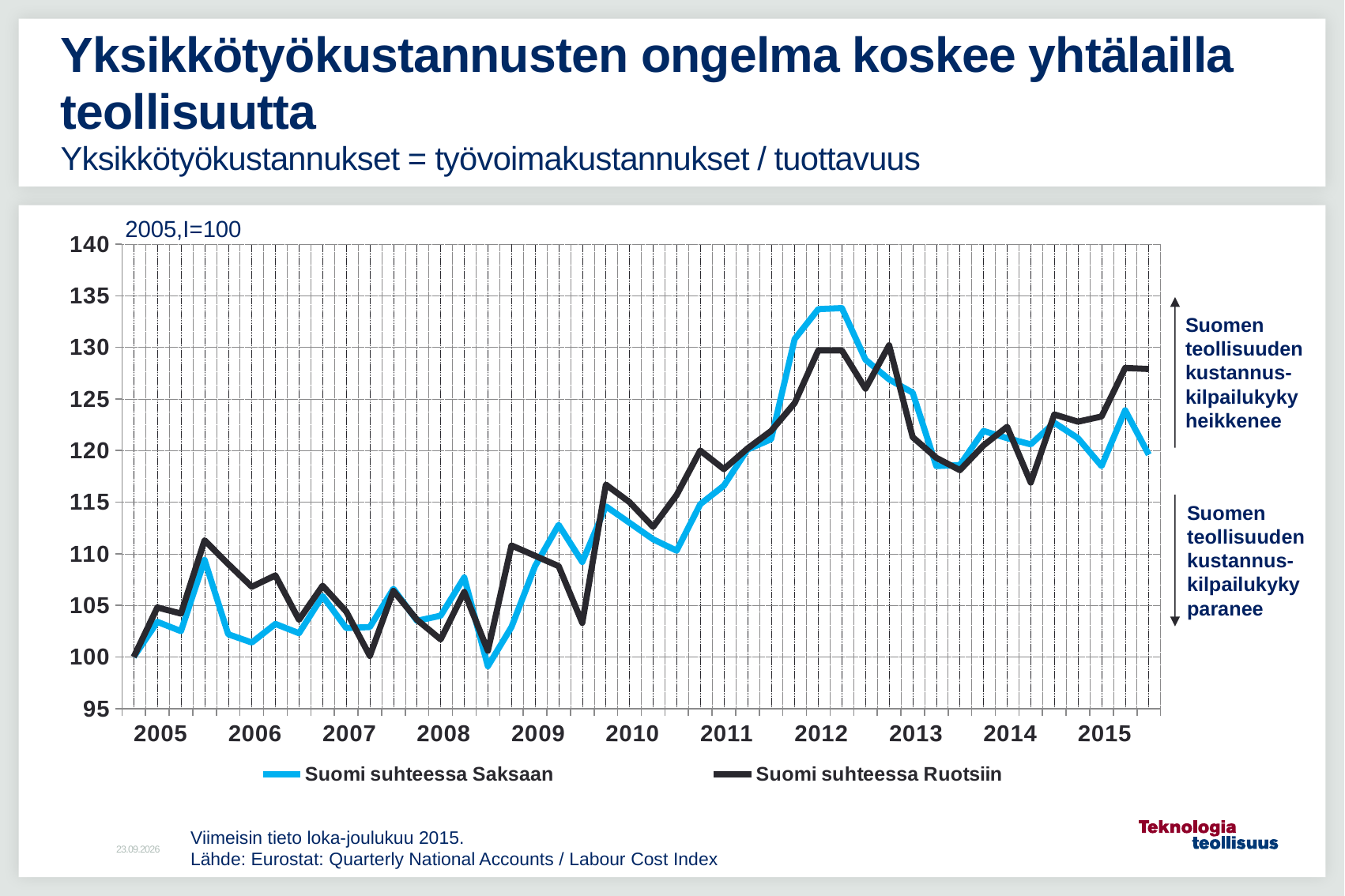
Which series reaches the highest value anywhere on the chart? Suomi suhteessa Saksaan At the end of 2015, which series is higher: 'Suomi suhteessa Saksaan' or 'Suomi suhteessa Ruotsiin'? Suomi suhteessa Ruotsiin In which year does the 'Suomi suhteessa Saksaan' series reach its highest value? 2012 Is the peak value of 'Suomi suhteessa Saksaan' in 2012 greater or less than 130? greater What kind of chart is shown on the slide? line chart How many years are labelled on the x axis? 11 What base-year note is printed above the y axis? 2005,I=100 Is the lowest value of 'Suomi suhteessa Saksaan' in 2008 greater or less than 100? less How many series does the legend list? 2 Which series is drawn in blue? Suomi suhteessa Saksaan Overall, do both series rise or fall from 2005 to 2012? rise Is the last 2015 value of 'Suomi suhteessa Ruotsiin' greater or less than 125? greater